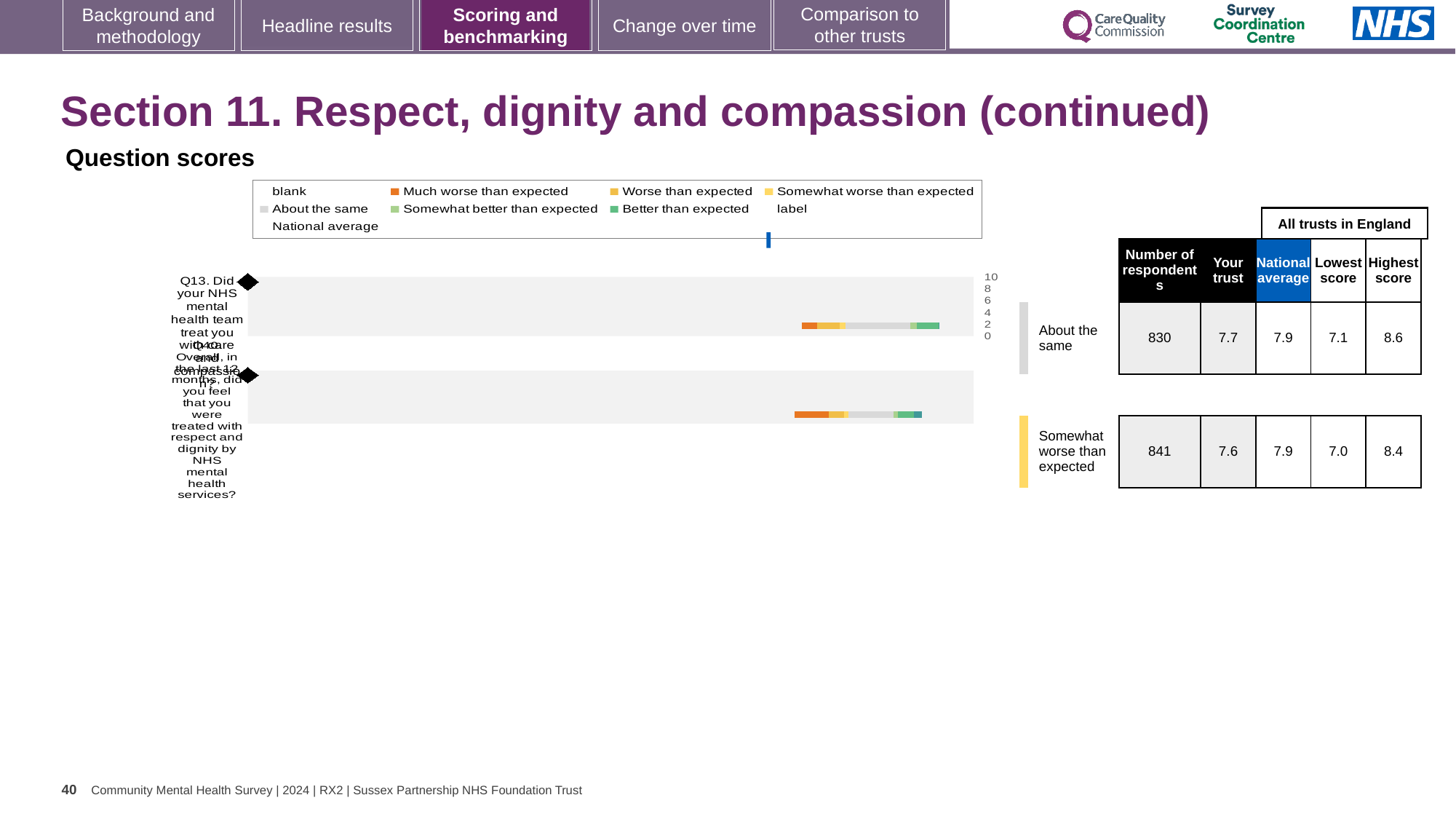
What is the 'Your trust' score for Q13? 7.7 What kind of chart is used to show the question scores on this slide? bar chart Which question had more respondents, Q13 or Q14? Q14 What is the national average score for Q13? 7.9 What is the difference between the national average and the 'Your trust' score for Q14? 0.3 What is the difference between the highest and lowest scores for Q13? 1.5 How many respondents answered Q14? 841 What is the 'Your trust' score for Q14? 7.6 What is the highest score among all trusts in England for Q13? 8.6 How many questions are plotted in the question scores chart? 2 Which benchmark category is Q14 placed in? Somewhat worse than expected What is the lowest score among all trusts in England for Q14? 7.0